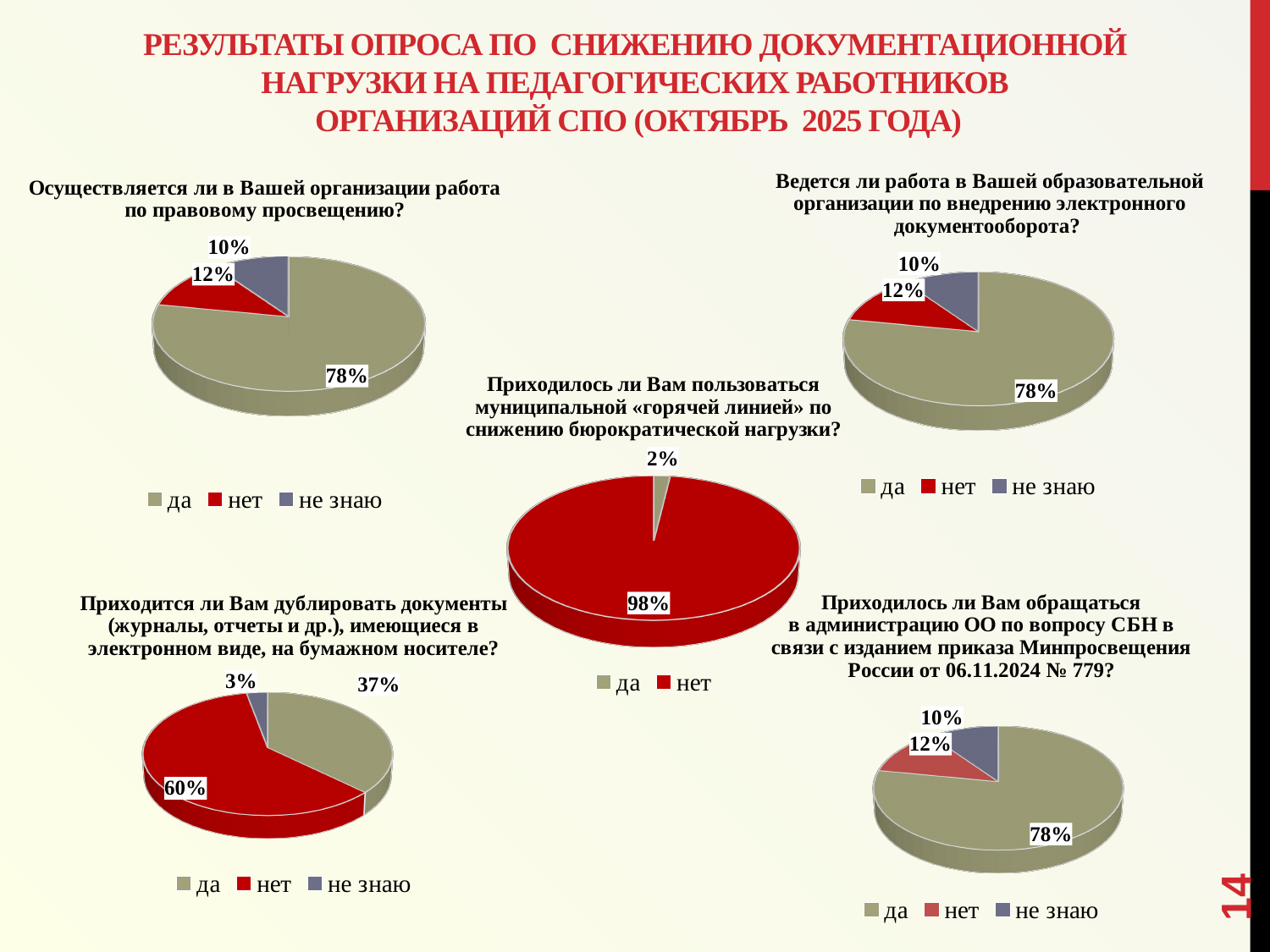
In the top-left pie chart (work on legal education), what share of respondents answered "не знаю"? 10% In the bottom-right pie chart (contacting the administration about order № 779), what share of respondents answered "да"? 78% In the bottom-left pie chart (duplicating documents on paper), which answer has the largest share? нет In the top-right pie chart (electronic document management), what share of respondents answered "нет"? 12% What type of chart is used for the top-right chart (electronic document management)? Pie chart In the center pie chart (municipal hotline), how many categories does the legend list? 2 In the top-left pie chart (work on legal education), what share of respondents answered "да"? 78% In the bottom-right pie chart (contacting the administration about order № 779), which is larger: the share for "нет" or for "не знаю"? нет In the bottom-left pie chart (duplicating documents on paper), which answer has the smallest share? не знаю In the bottom-left pie chart (duplicating documents on paper), what is the difference between the shares for "нет" and "да"? 23% How many pie charts are shown on the slide? 5 In the center pie chart (municipal hotline), what share of respondents answered "нет"? 98%